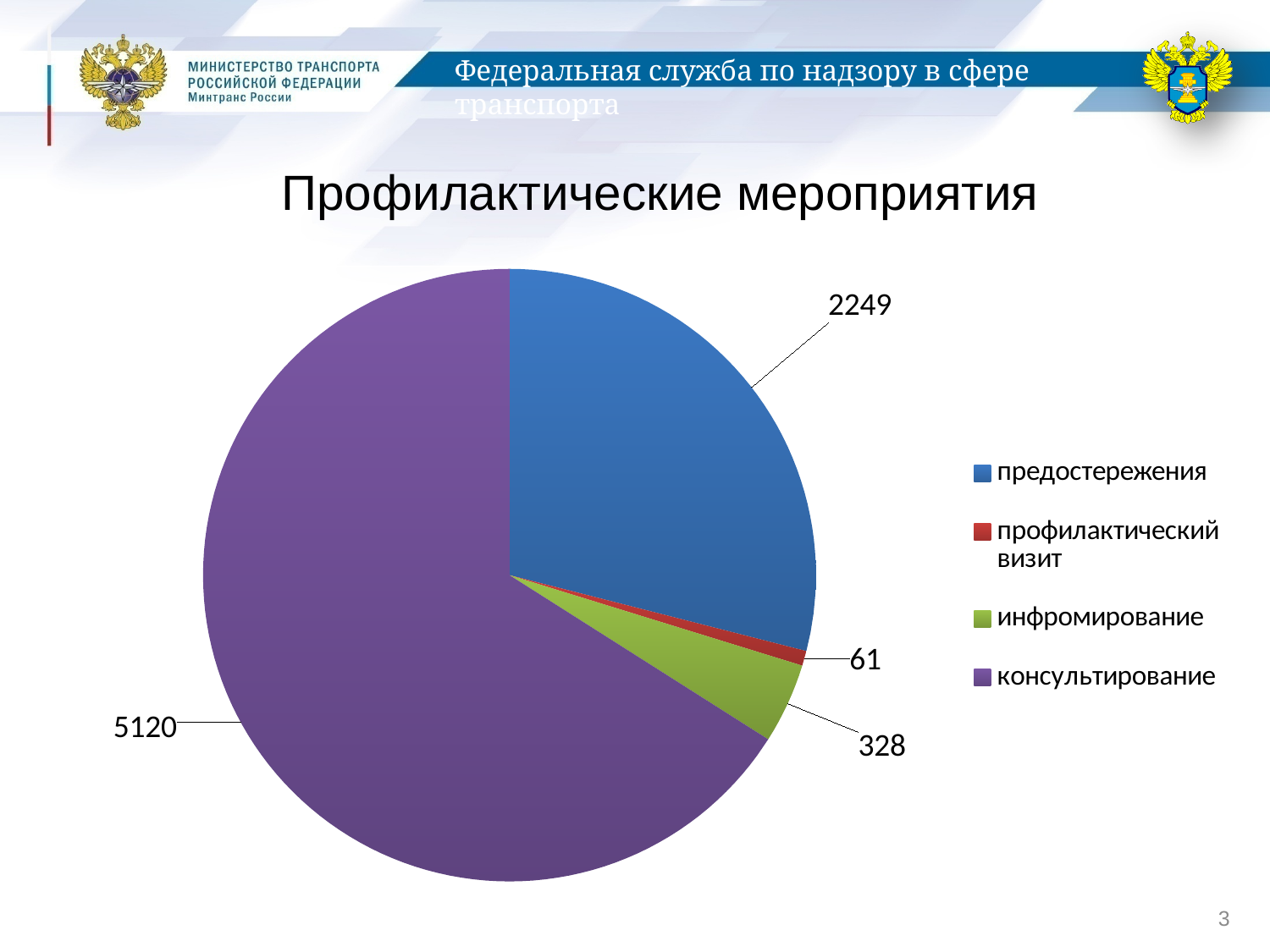
What is the value for инфромирование? 328 What is the title of the chart? Профилактические мероприятия What type of chart is shown on the slide? Pie chart What is the difference between the values for инфромирование and профилактический визит? 267 How many categories does the pie chart have? 4 What is the value for профилактический визит? 61 What is the value for предостережения? 2249 What is the difference between the values for консультирование and предостережения? 2871 Which category has the smallest slice of the pie? профилактический визит Which is larger, the value for предостережения or the value for инфромирование? предостережения What is the value for консультирование? 5120 Which category has the largest slice of the pie? консультирование